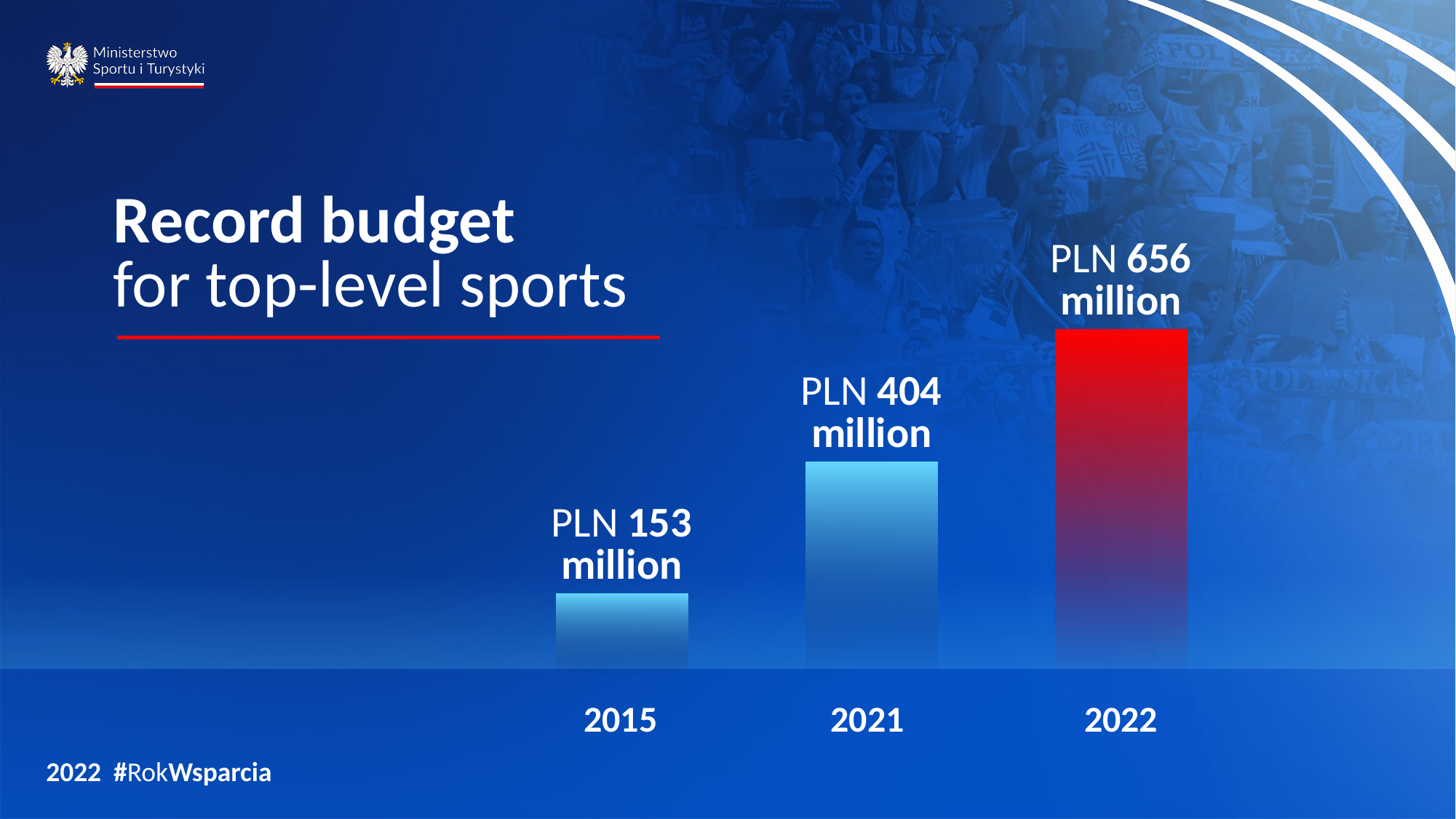
What kind of chart is shown on the slide? Bar chart What is the difference between the 2022 and 2021 budgets? PLN 252 million Which bar is coloured red? 2022 What is the budget value shown for 2022? PLN 656 million Which year has the highest budget? 2022 Do the budget values rise or fall from 2015 to 2022? Rise Which is larger, the budget for 2015 or for 2021? 2021 What is the budget value shown for 2015? PLN 153 million Which year has the lowest budget? 2015 What is the difference between the 2021 and 2015 budgets? PLN 251 million What is the budget value shown for 2021? PLN 404 million How many years are shown in the chart? 3